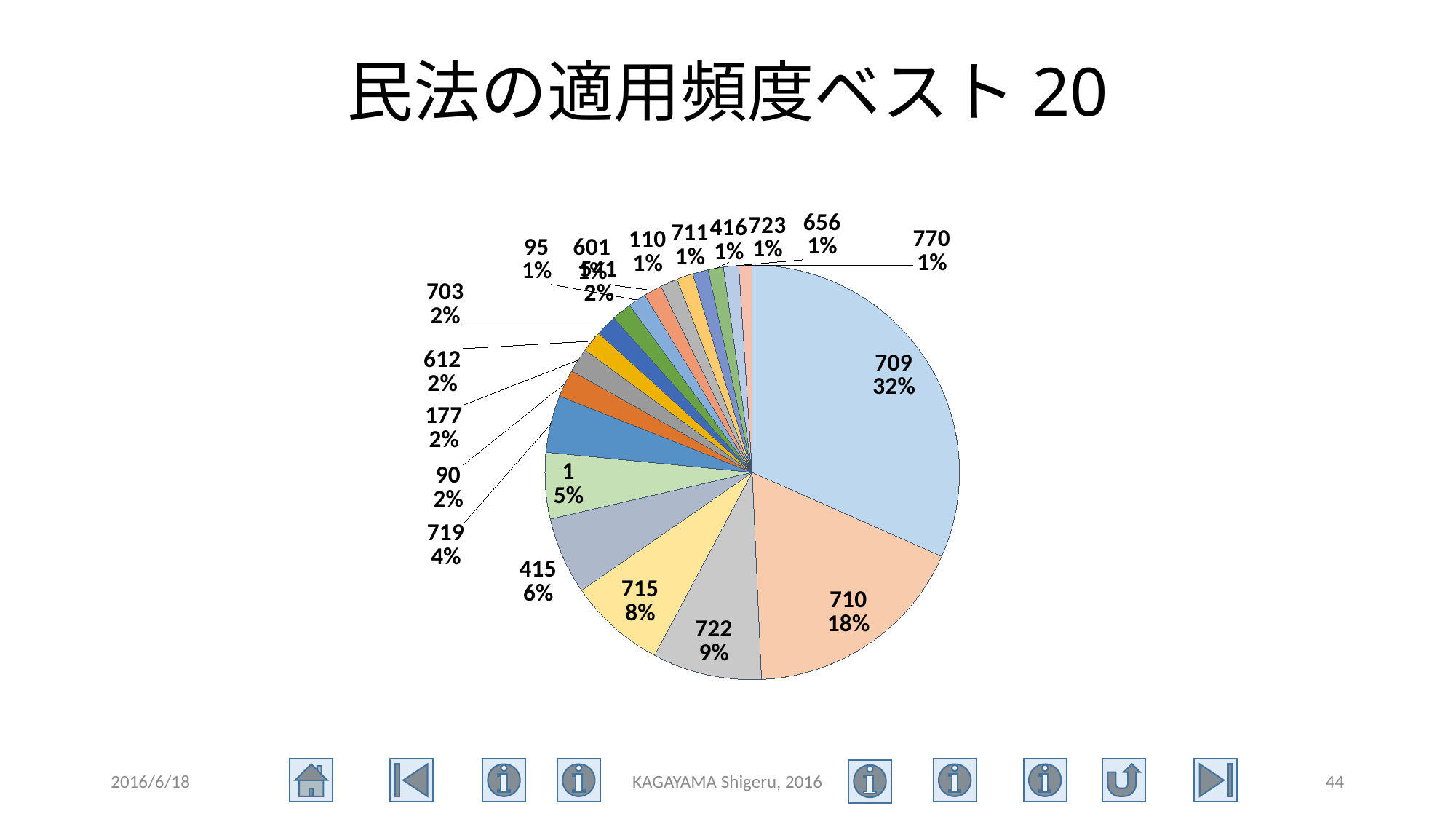
What percentage is shown for article 415? 6% What percentage is shown for article 1? 5% What percentage is shown for article 719? 4% What is the difference in percentage points between article 709 and article 710? 14 What kind of chart is shown on the slide? pie chart Which has the larger share, article 722 or article 415? 722 What is the title of the chart on the slide? 民法の適用頻度ベスト 20 Which article has the largest slice of the pie? 709 What percentage is shown for article 715? 8% What share of the pie does article 710 have? 18% What share of the pie does article 709 have? 32% What percentage is shown for article 722? 9%